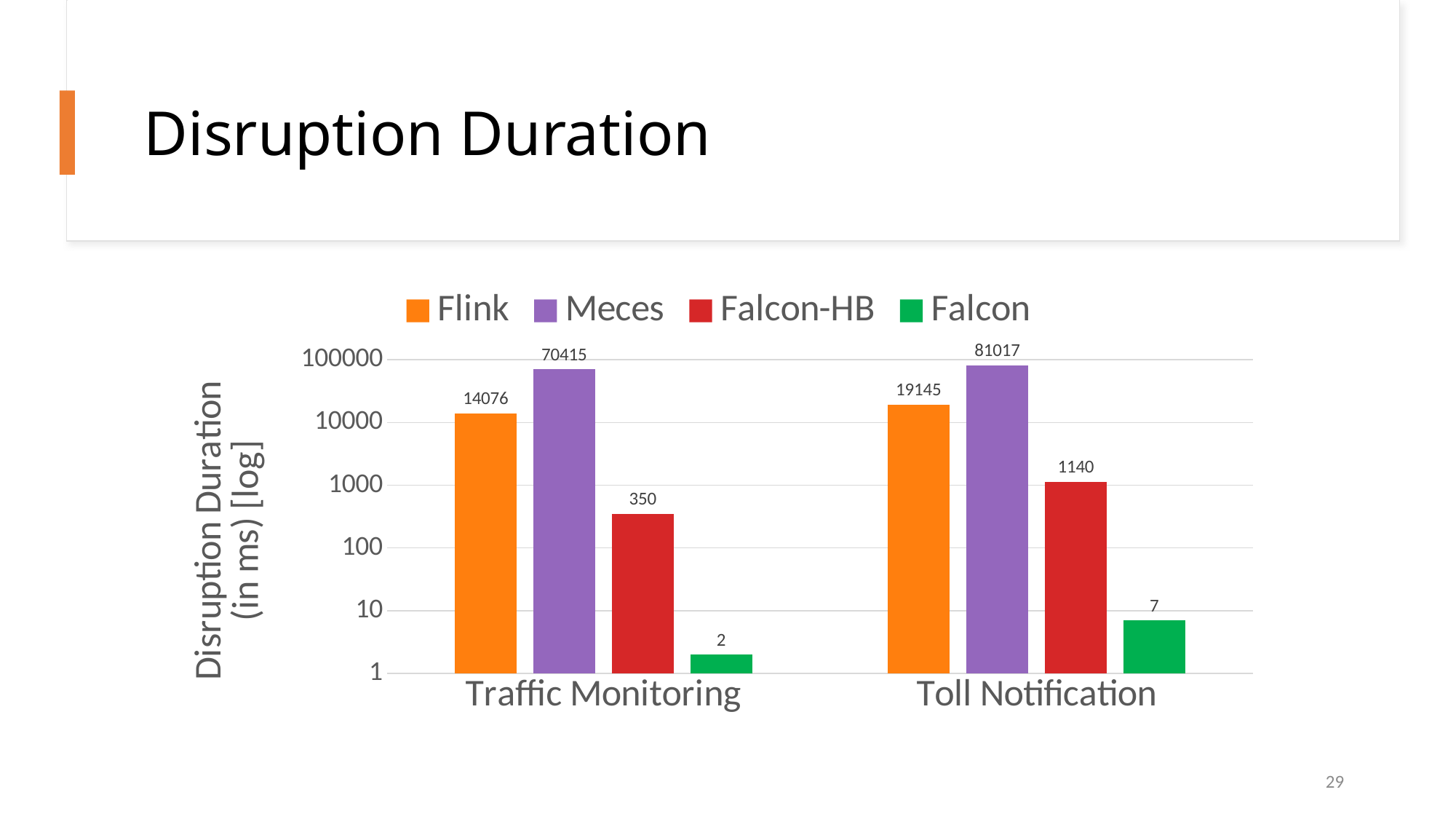
What kind of chart is shown on the slide? Bar chart How many series does the legend list? 4 Which series has the highest disruption duration in the Toll Notification category? Meces Is the Flink value for Traffic Monitoring greater or less than 10000? greater What is the disruption duration for Meces in the Traffic Monitoring category? 70415 What is the difference between the Flink values for Toll Notification and Traffic Monitoring? 5069 What is the disruption duration for Falcon-HB in the Toll Notification category? 1140 What is the disruption duration for Falcon in the Traffic Monitoring category? 2 What is the label of the y axis? Disruption Duration (in ms) [log] How many categories are shown on the x axis? 2 Which is larger: the Falcon-HB value for Traffic Monitoring or for Toll Notification? Toll Notification Which series has the lowest disruption duration in the Traffic Monitoring category? Falcon